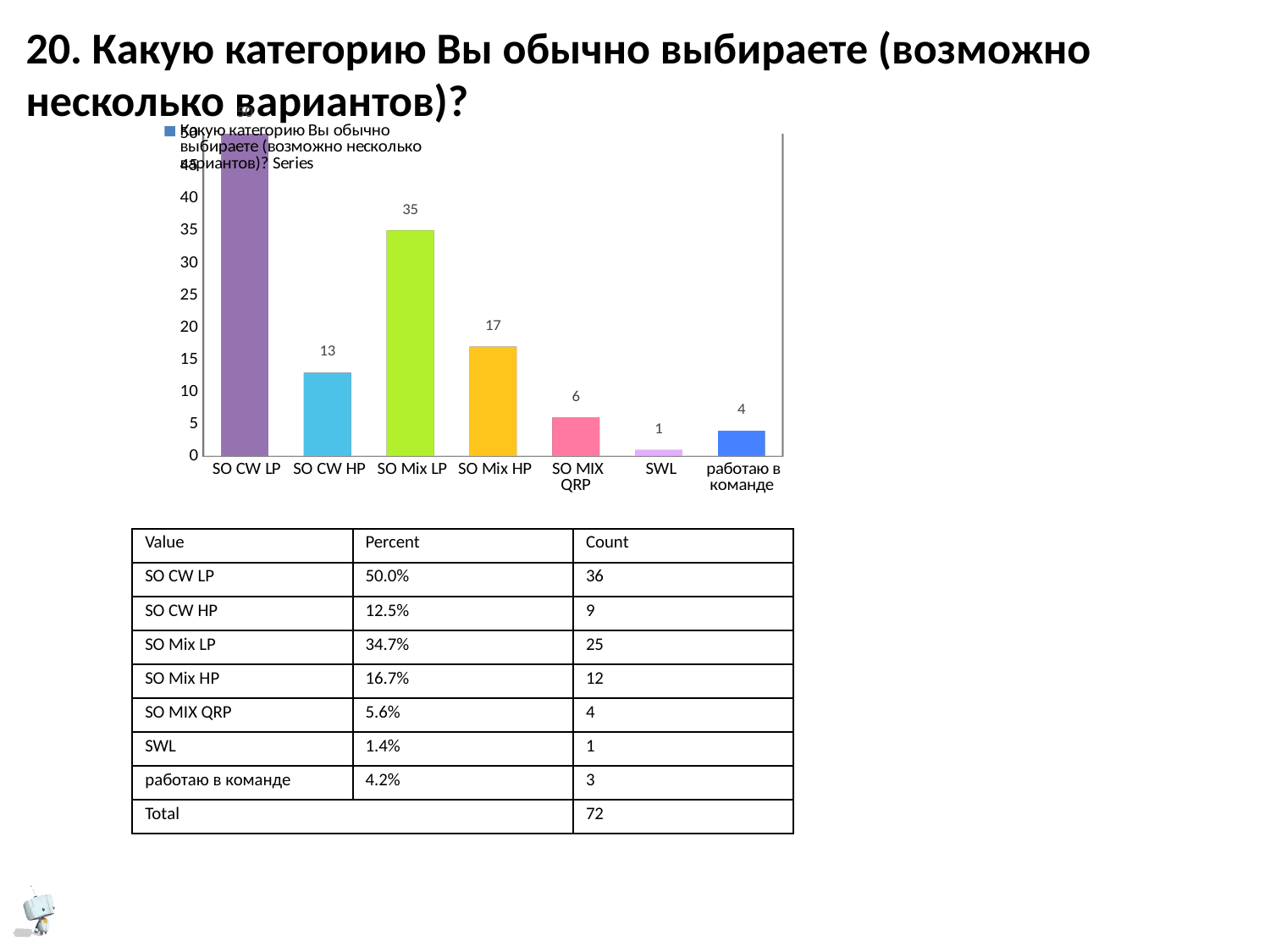
What is the value for SO Mix LP in the chart? 35 Is the value for SO CW LP in the chart greater or less than 40? greater What is the value for SO Mix HP in the chart? 17 Which category has the highest bar in the chart? SO CW LP Which category has the lowest bar in the chart? SWL How many categories are shown on the x axis of the chart? 7 What type of chart is shown on the slide? bar chart What is the value for 'работаю в команде' in the chart? 4 What is the value for SO CW HP in the chart? 13 What is the difference between the values for SO Mix LP and SO Mix HP in the chart? 18 What is the value for SWL in the chart? 1 What is the value for SO MIX QRP in the chart? 6